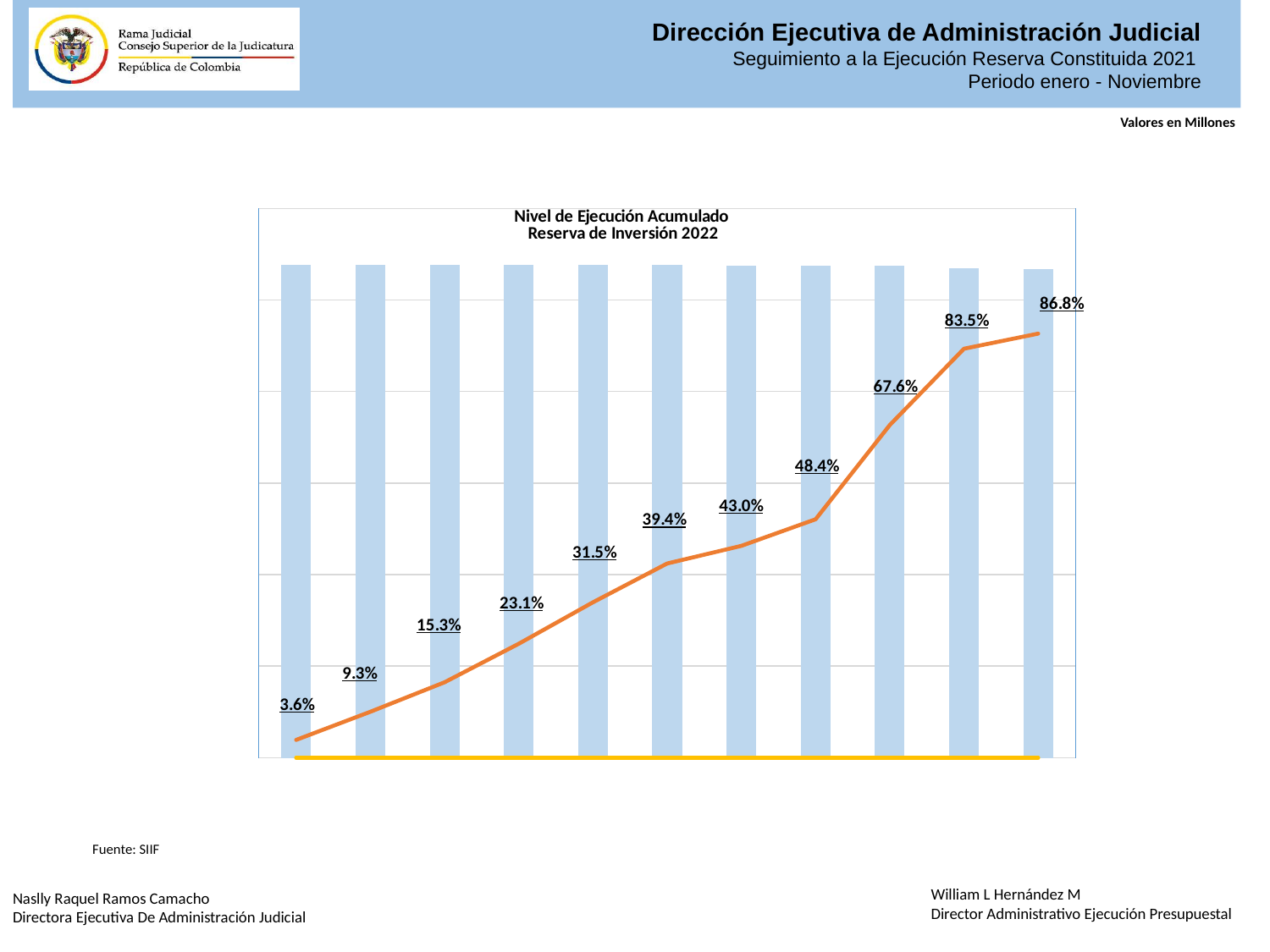
How many data points are labelled on the orange line? 11 What is the value of the fifth point from the left on the line? 31.5% What is the value of the last (rightmost) point on the line? 86.8% Which is larger, the value of the seventh point (43.0%) or the sixth point (39.4%)? 43.0% What is the lowest value labelled on the line? 3.6% What is the difference between the point labelled 48.4% and the point labelled 67.6%? 19.2% What is the value of the first (leftmost) point on the line? 3.6% What is the highest value labelled on the line? 86.8% What is the value of the ninth point from the left on the line? 67.6% What is the title of the chart? Nivel de Ejecución Acumulado Reserva de Inversión 2022 What is the difference between the last point (86.8%) and the second-to-last point (83.5%)? 3.3% Do the values on the line rise or fall from left to right? rise